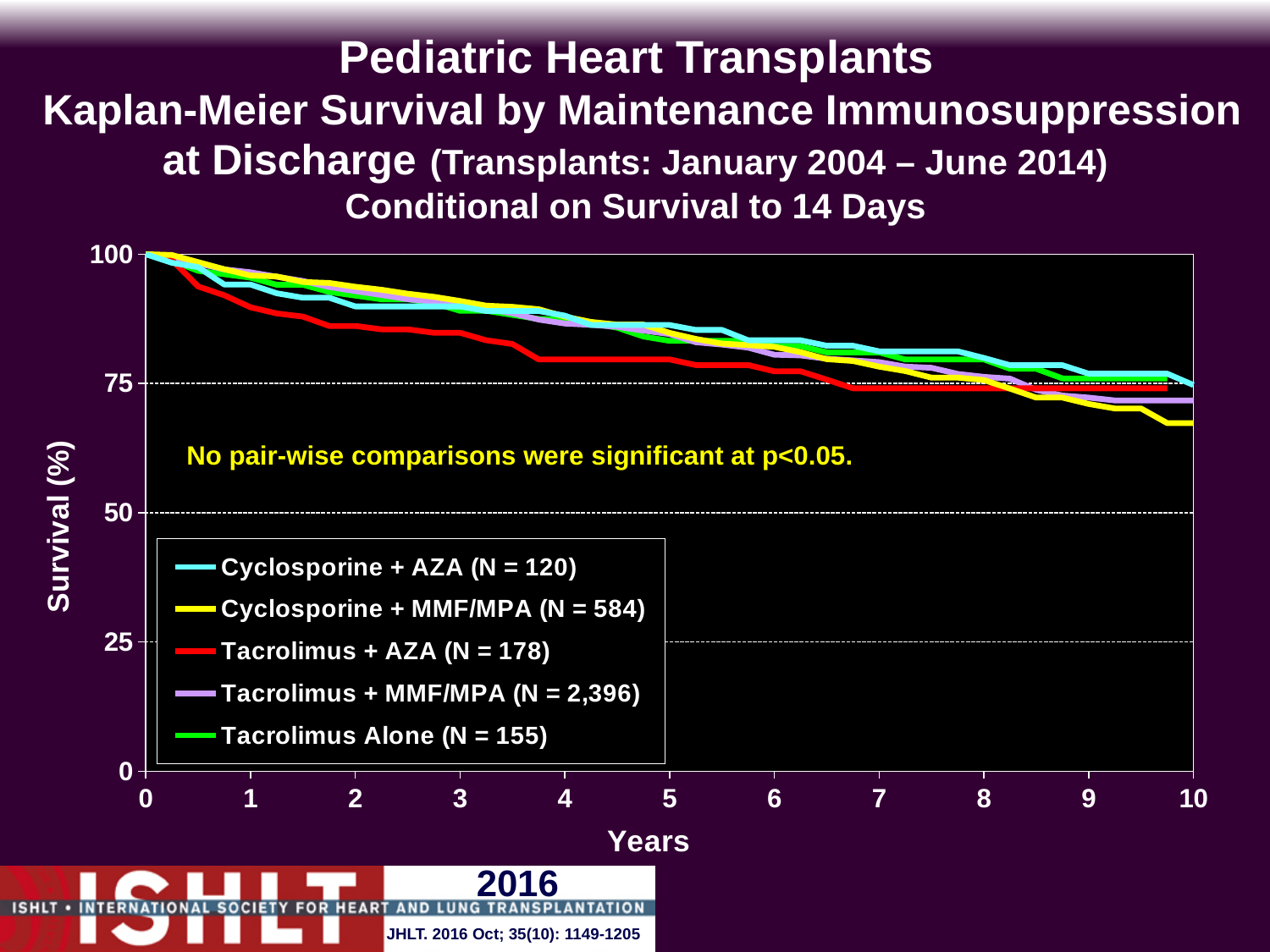
How many series does the legend list? 5 How many tick marks are labelled on the Years axis? 11 Is the survival value for Tacrolimus + AZA at year 5 greater or less than 75? greater What does the annotation inside the chart say about pair-wise comparisons? No pair-wise comparisons were significant at p<0.05. Do the survival curves rise or fall as the years increase? Fall What kind of chart is shown on the slide? Line chart Which series has the lowest survival at year 5? Tacrolimus + AZA Which legend group has the largest N? Tacrolimus + MMF/MPA (N = 2,396) Is the survival value for Tacrolimus + AZA at year 2 greater or less than 75? greater Is the survival value for Cyclosporine + AZA at year 1 greater or less than 75? greater Which series has the lowest survival at year 10? Cyclosporine + MMF/MPA